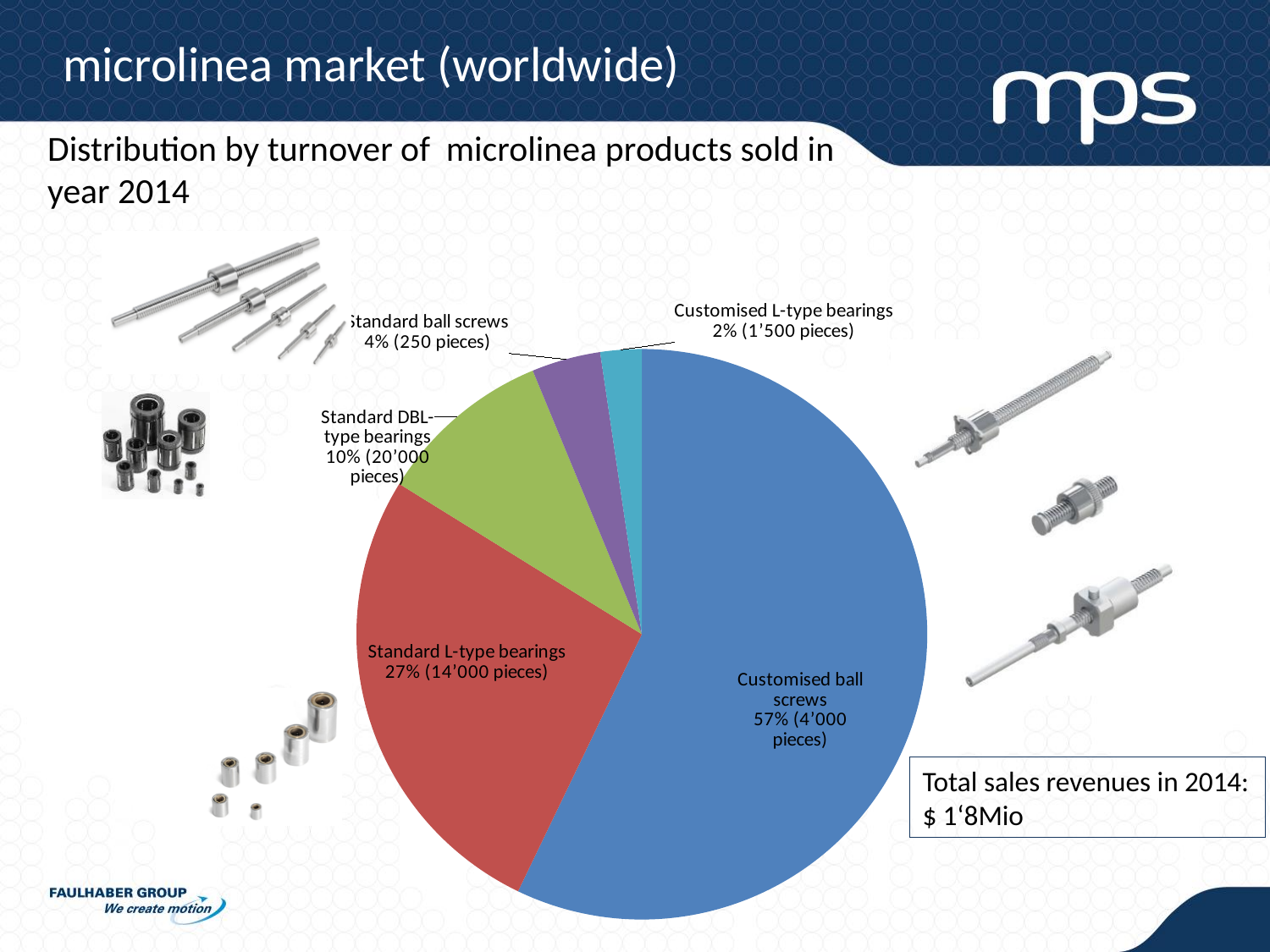
How many pieces of Standard DBL-type bearings were sold according to the chart? 20'000 pieces How many pieces of Standard ball screws were sold according to the chart? 250 pieces Which has a larger share of turnover, Standard ball screws or Standard DBL-type bearings? Standard DBL-type bearings Which product category has the largest share of turnover? Customised ball screws What share of turnover do Customised L-type bearings account for? 2% What share of turnover do Standard DBL-type bearings account for? 10% What share of turnover do Standard L-type bearings account for? 27% Which product category has the smallest share of turnover? Customised L-type bearings What is the difference in percentage points between the shares of Customised ball screws and Standard L-type bearings? 30 percentage points How many slices does the pie chart have? 5 What kind of chart is shown on the slide? Pie chart